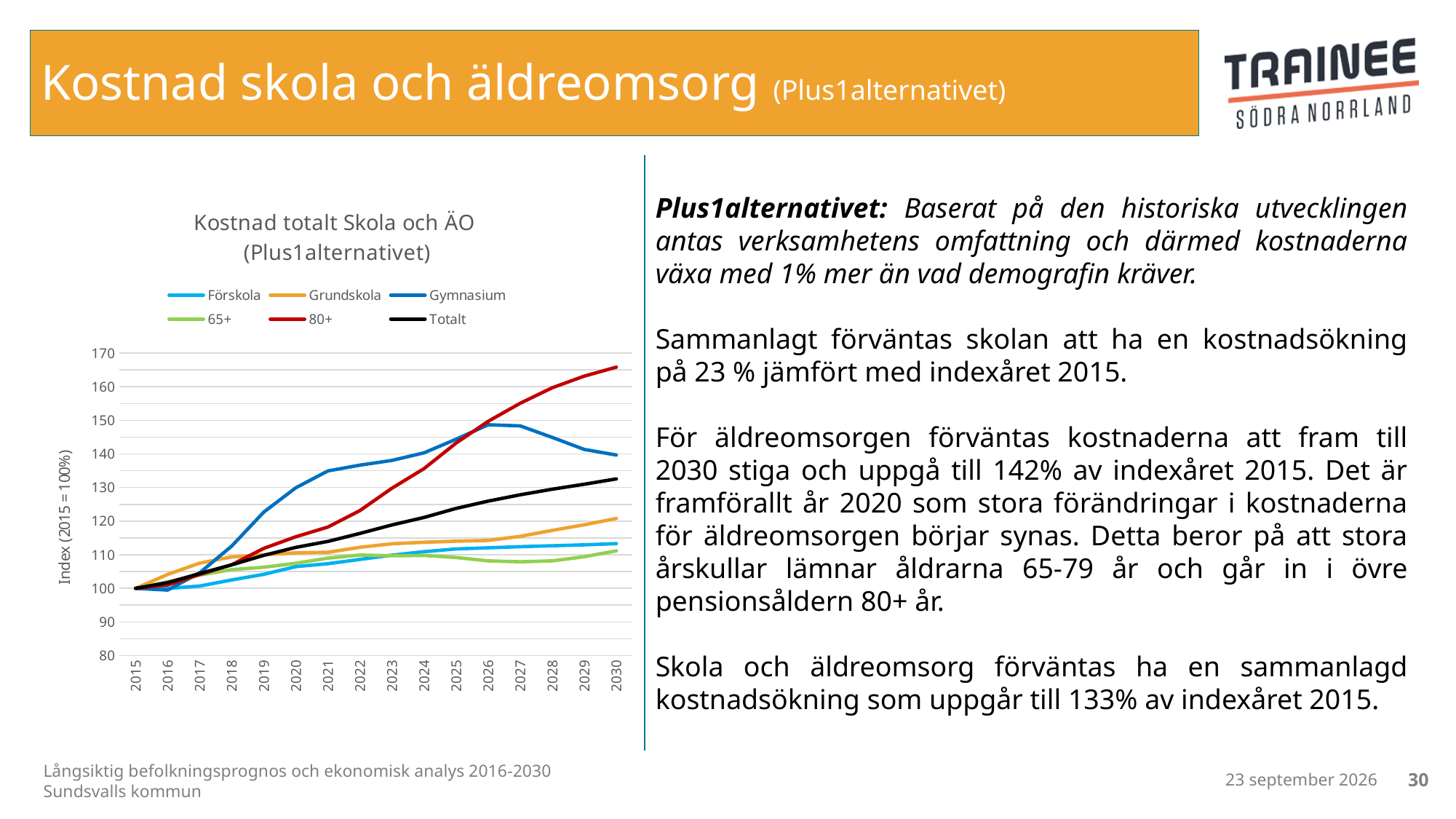
Is the value for Totalt in 2030 greater or less than 130? greater Which series has the lowest value in 2030? 65+ Is the value for 80+ in 2030 greater or less than 160? greater Does the 80+ series rise or fall from 2015 to 2030? Rises What is the index value for Totalt in 2015? 100 How many years are shown along the x axis of the chart? 16 In 2030, which is larger: Gymnasium or Grundskola? Gymnasium What is the title of the chart? Kostnad totalt Skola och ÄO (Plus1alternativet) Is the value for Förskola in 2030 greater or less than 120? less How many series does the chart legend list? 6 What kind of chart is shown on the slide? Line chart Which series has the highest value in 2030? 80+